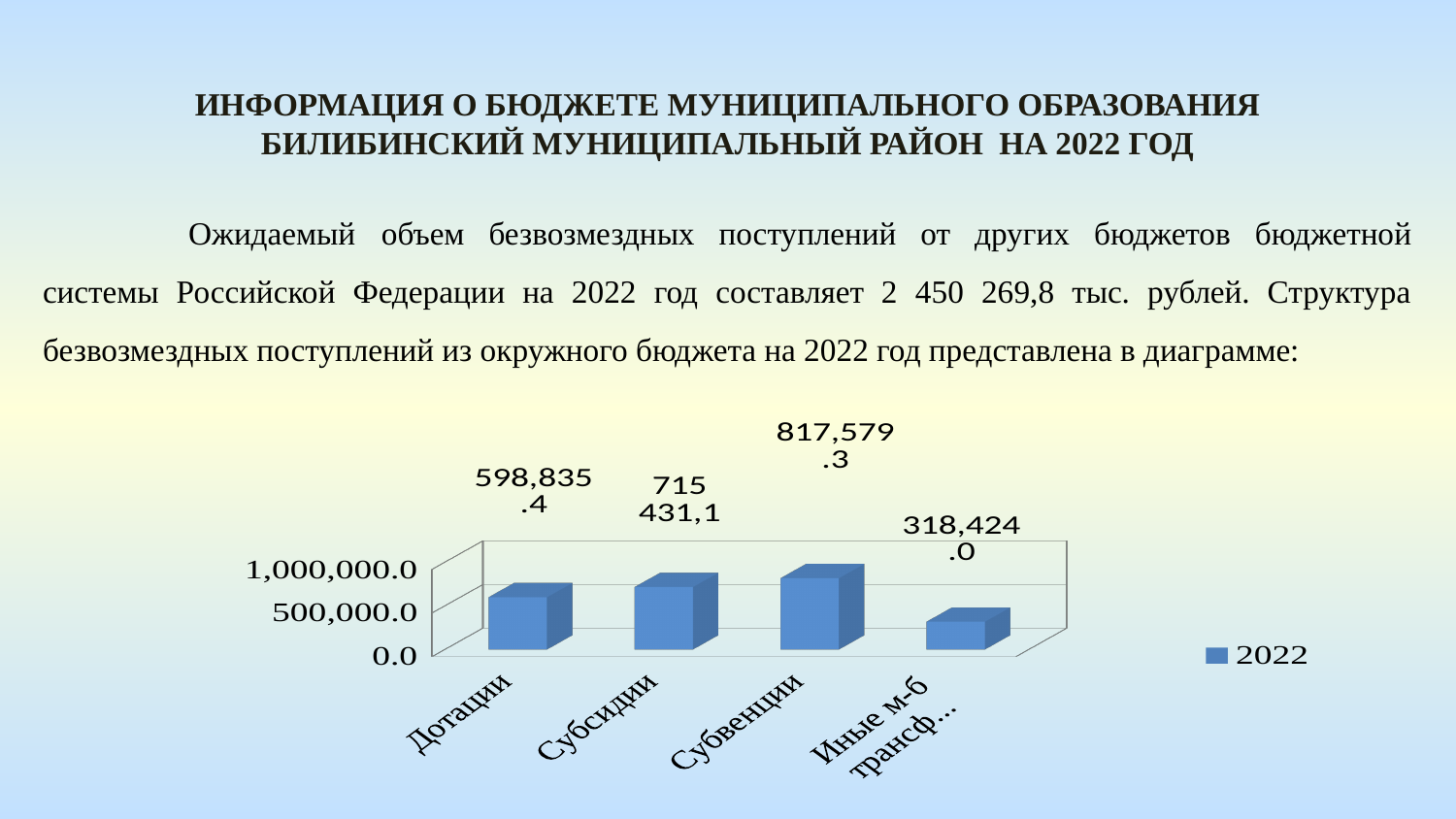
What is the value for the category labelled Иные м-б трансф...? 318,424.0 How many categories are shown on the chart? 4 What is the value for Субвенции? 817,579.3 Which is larger, the value for Субсидии or the value for Дотации? Субсидии What is the value for Субсидии? 715 431,1 What is the difference between the values for Субвенции and Дотации? 218,743.9 Which category has the lowest value? Иные м-б трансф... Which category has the highest value? Субвенции What is the value for Дотации? 598,835.4 What is the difference between the values for Дотации and Иные м-б трансф...? 280,411.4 What series does the legend list? 2022 Is the value for Иные м-б трансф... greater or less than 500,000.0? less